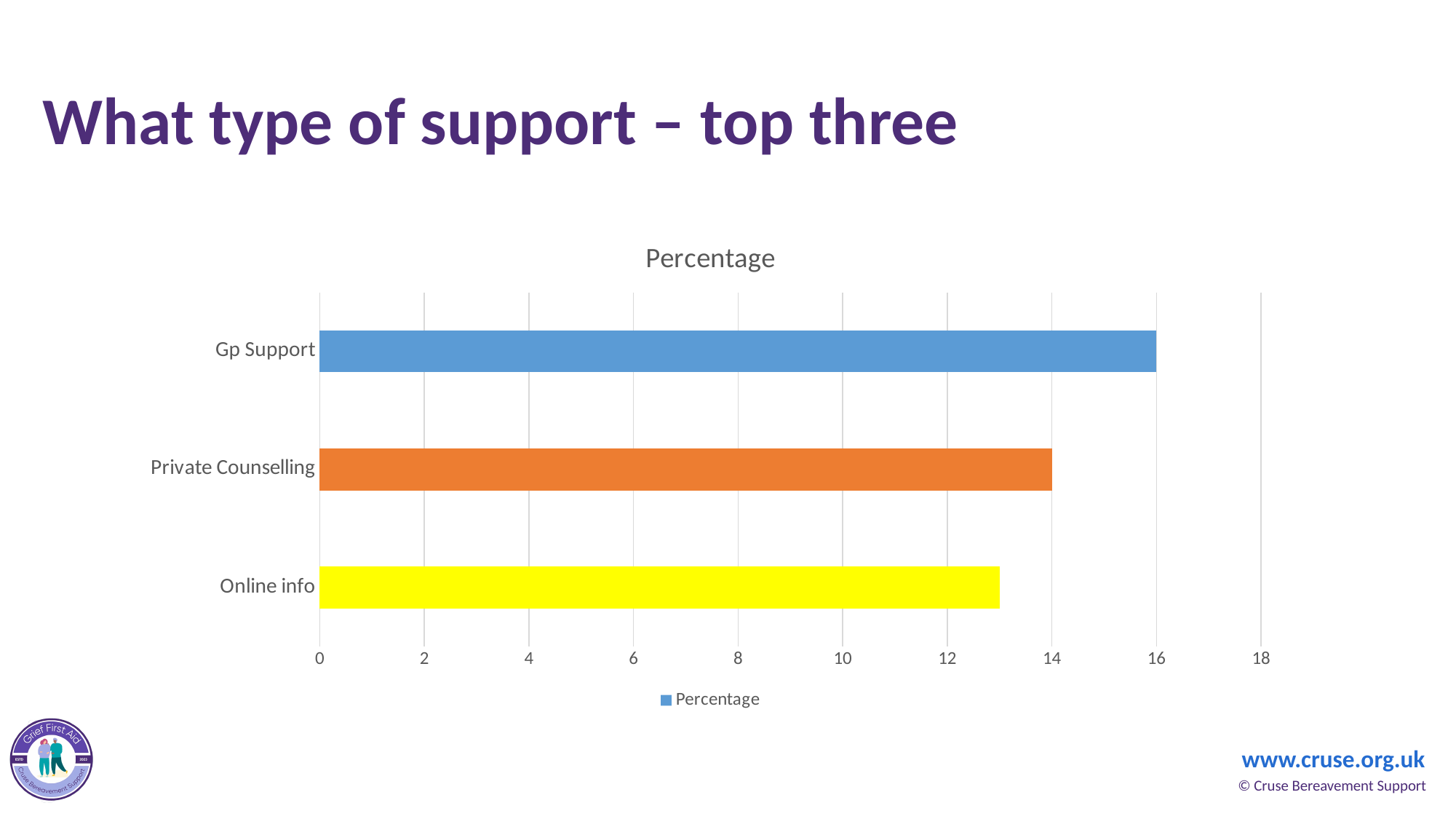
Is the value for Online info greater or less than 14? less What is the title of the chart? Percentage How many categories are shown in the chart? 3 How many series does the legend list? 1 Is the value for Online info greater or less than 12? greater Which is larger, the value for Private Counselling or the value for Online info? Private Counselling What is the value for Private Counselling? 14 What is the value for Gp Support? 16 What kind of chart is shown on the slide? bar chart Which category has the lowest value? Online info What is the difference between the values for Gp Support and Private Counselling? 2 Which category has the highest value? Gp Support